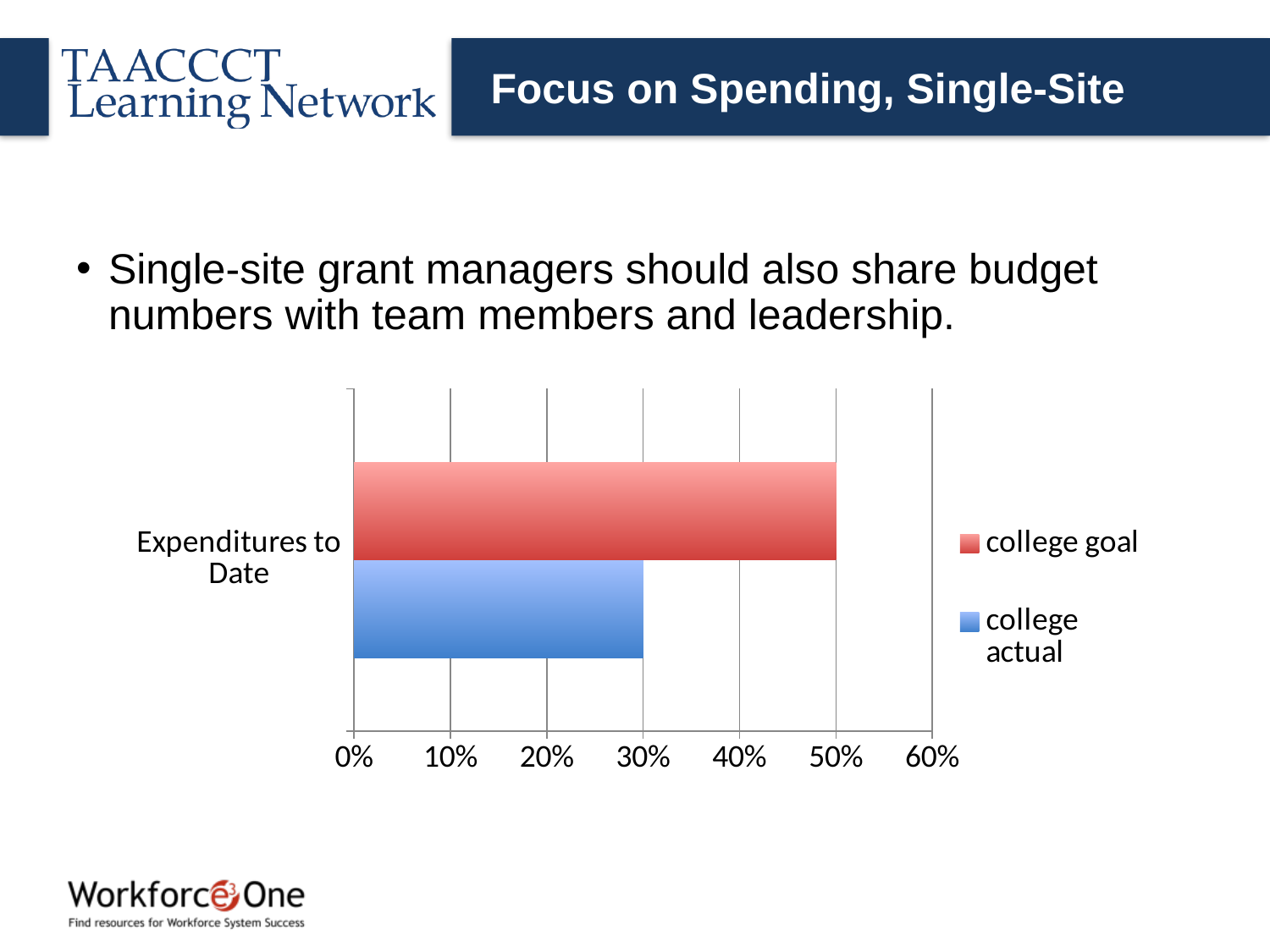
What is the value of the college actual bar for Expenditures to Date? 30% What kind of chart is shown on the slide? bar chart Which series shows the lowest value on the chart? college actual What is the label of the category shown on the chart's vertical axis? Expenditures to Date How many series does the chart legend list? 2 Is the college goal value for Expenditures to Date greater or less than 40%? greater What is the difference between the college goal and college actual values for Expenditures to Date? 20% What colour is the college actual series in the chart? blue Which series has the larger value for Expenditures to Date, college goal or college actual? college goal How many categories are plotted on the chart's vertical axis? 1 Is the college actual value for Expenditures to Date greater or less than 40%? less What is the value of the college goal bar for Expenditures to Date? 50%